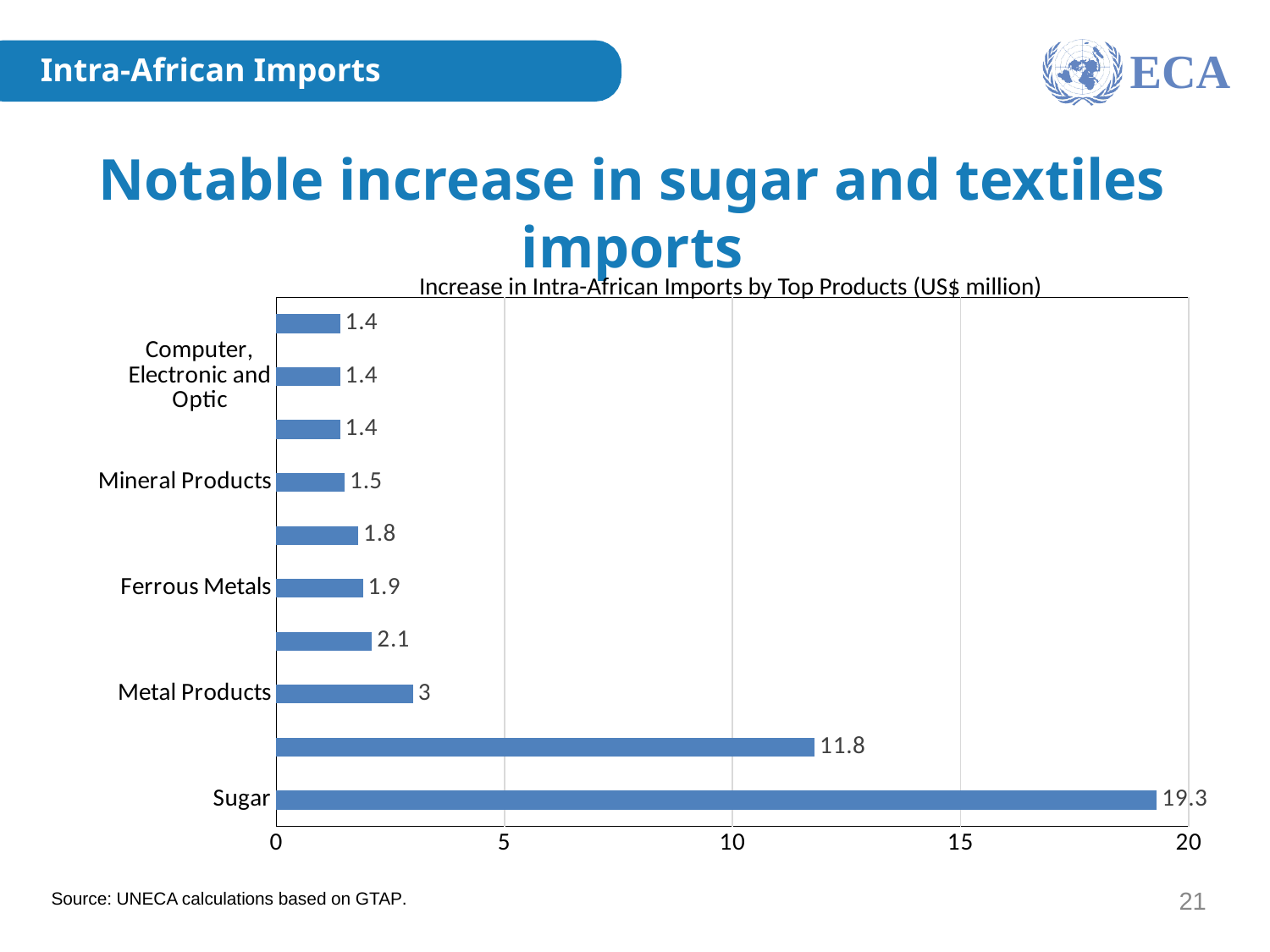
What is the difference between the values for Sugar and Metal Products? 16.3 What is the value for Mineral Products? 1.5 What type of chart is shown on the slide? Bar chart How many bars are plotted in the chart? 10 What is the value for Sugar? 19.3 What is the difference between the values for Metal Products and Mineral Products? 1.5 Is the value for Sugar greater or less than 15? greater Which product has the highest increase in intra-African imports? Sugar What is the value for Computer, Electronic and Optic? 1.4 What is the value for Ferrous Metals? 1.9 What is the value for Metal Products? 3 Which is larger, the value for Metal Products or the value for Ferrous Metals? Metal Products